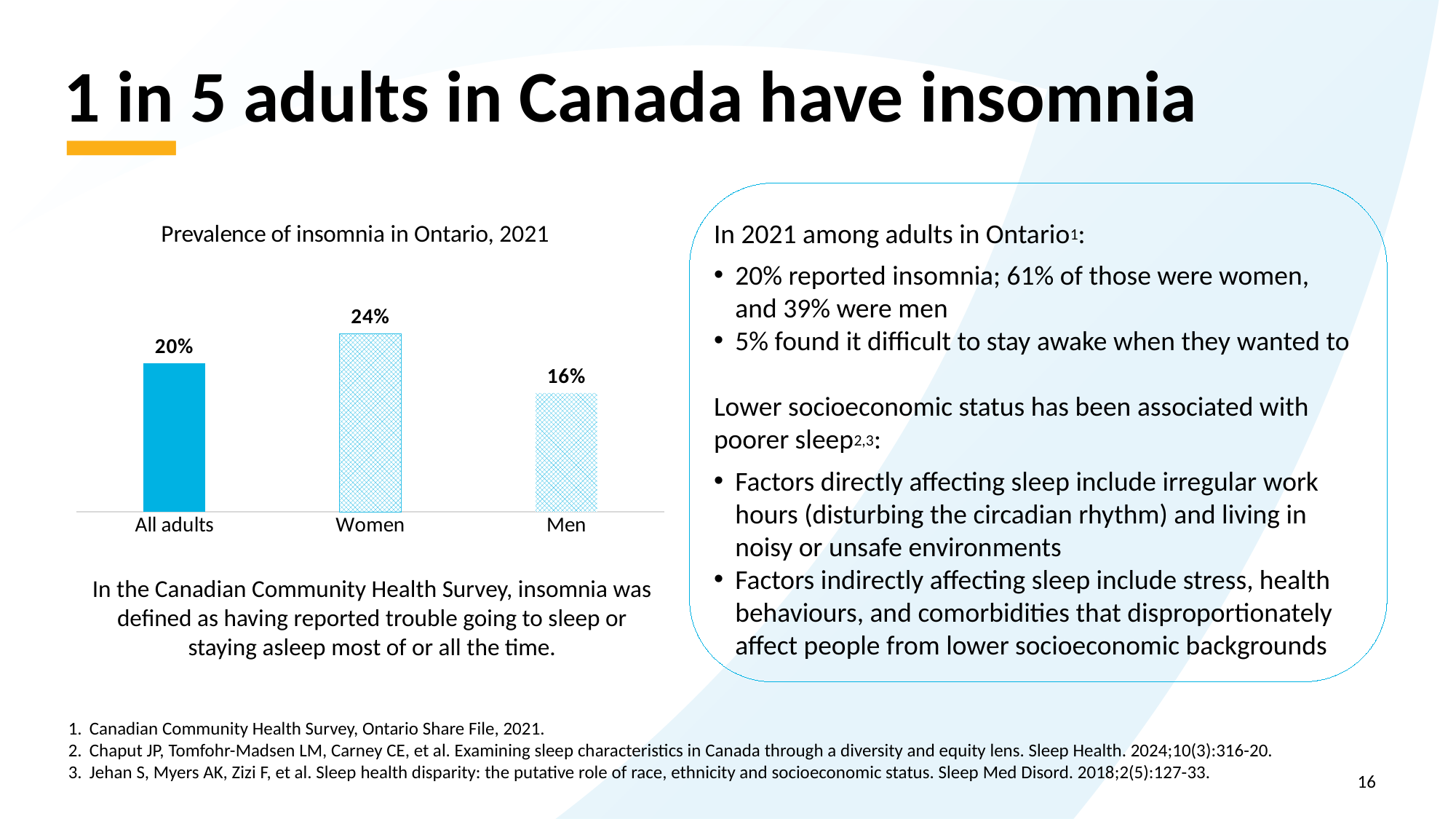
Which bar in the chart is solid-filled rather than patterned? All adults What is the difference in insomnia prevalence between Women and Men? 8% What kind of chart is shown on the slide? Bar chart What is the title of the chart? Prevalence of insomnia in Ontario, 2021 How many categories are shown in the chart? 3 Which category has the highest prevalence of insomnia in the chart? Women What is the prevalence of insomnia for Men in the chart? 16% What is the prevalence of insomnia for All adults in the chart? 20% Which category has the lowest prevalence of insomnia in the chart? Men What is the prevalence of insomnia for Women in the chart? 24% What is the difference in insomnia prevalence between Women and All adults? 4% Which has a higher prevalence of insomnia, Women or Men? Women